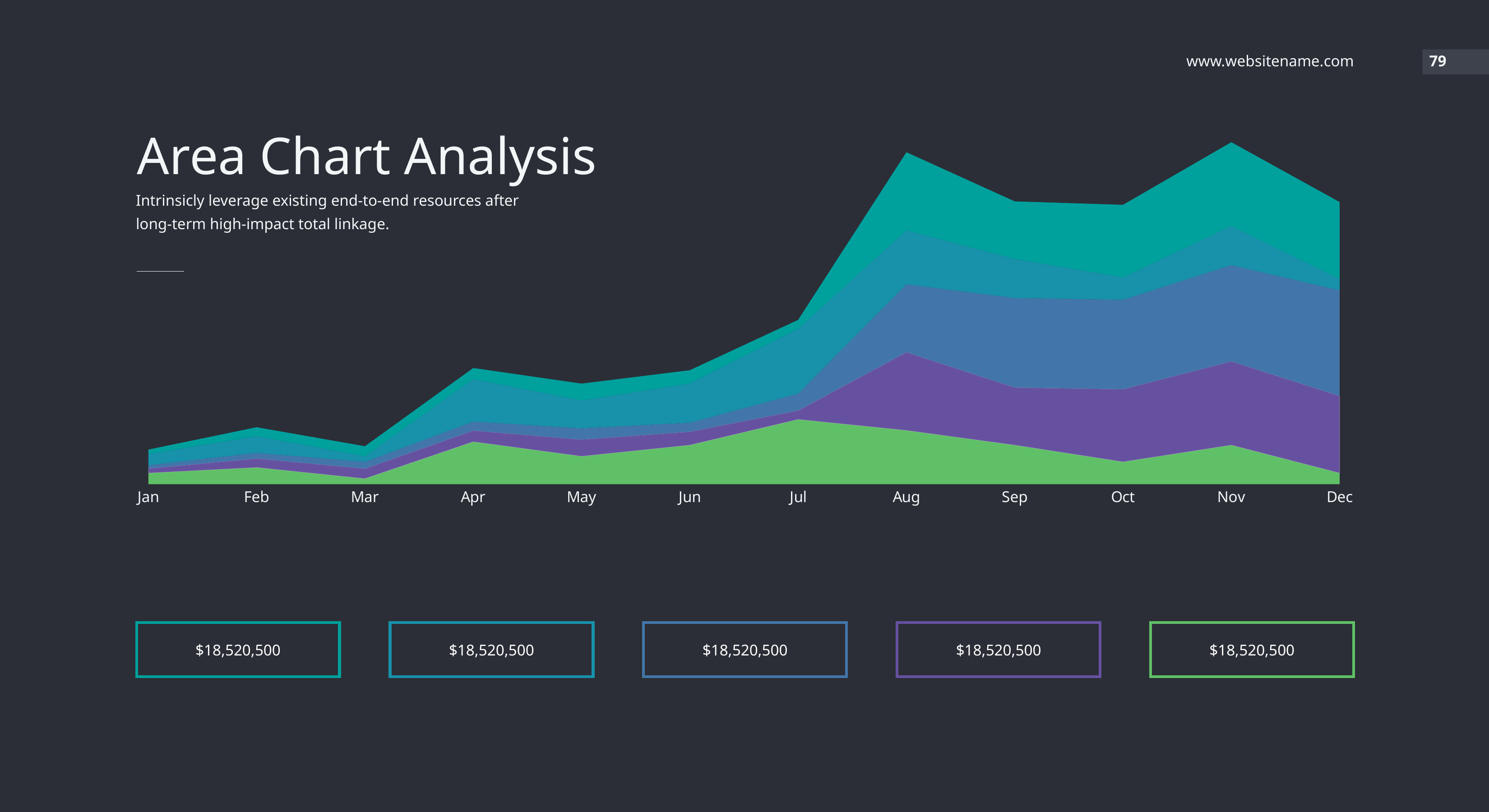
Is the stacked total larger in Aug or in Apr? Aug Between Jul and Aug, does the stacked total rise or fall? Rise How many months are shown along the x axis of the chart? 12 How many coloured series are stacked in the area chart? 5 What is the title of the slide containing the chart? Area Chart Analysis In which month does the bottom green series reach its highest value? Jul Is the stacked total larger in Jul or in Jun? Jul Which colour is the series at the bottom of the stack? Green In which month does the stacked total reach its highest point? Nov Between Aug and Sep, does the stacked total rise or fall? Fall What kind of chart is shown on the slide? Stacked area chart